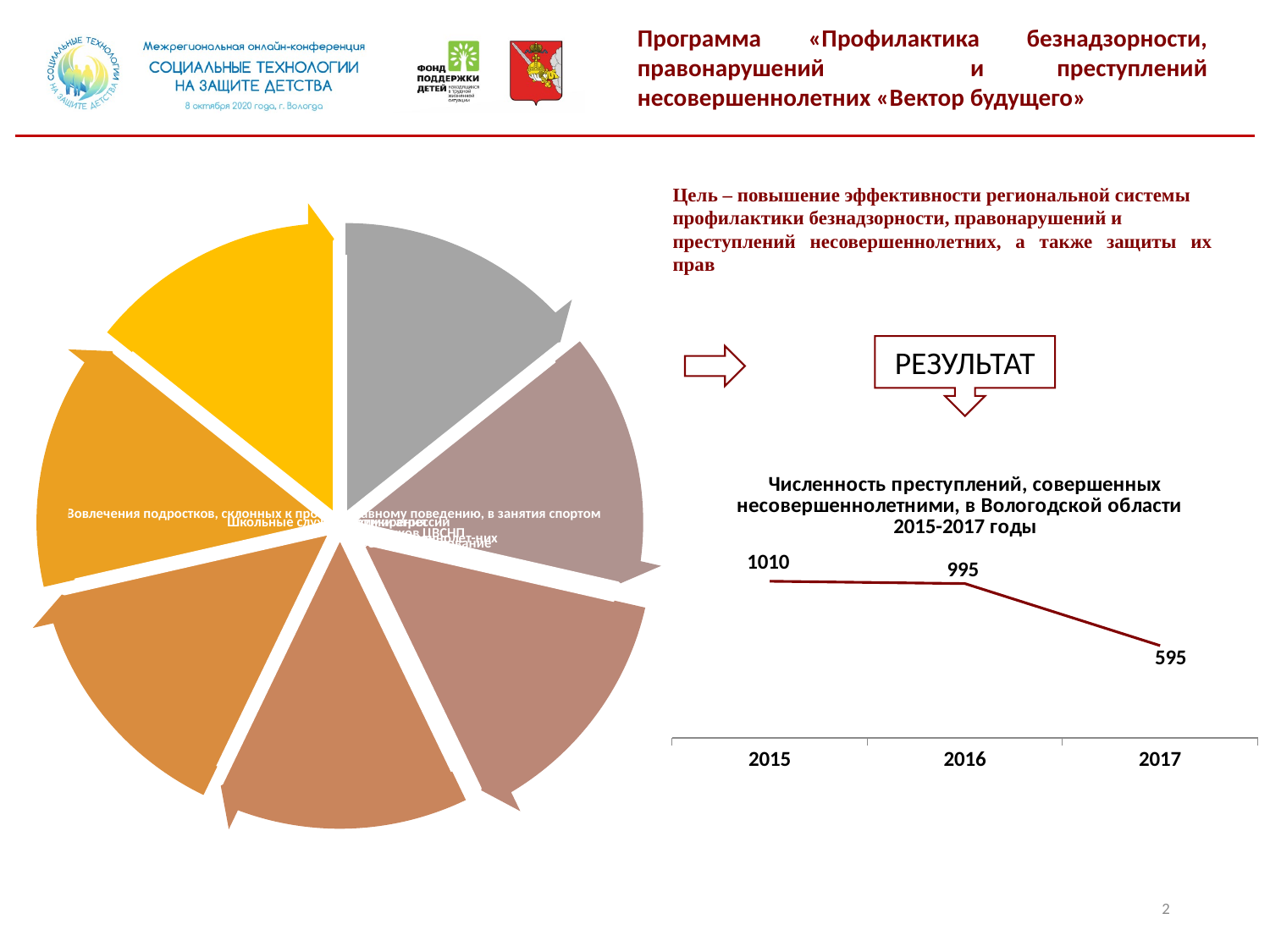
In the line chart on the right of the slide, what is the difference between the values for 2015 and 2016? 15 In the line chart on the right of the slide, which is larger: the value for 2015 or the value for 2017? 2015 What kind of chart is shown on the right of the slide under the word "РЕЗУЛЬТАТ"? line chart In the line chart on the right of the slide, which year has the highest value? 2015 What is the title of the line chart on the right of the slide? Численность преступлений, совершенных несовершеннолетними, в Вологодской области 2015-2017 годы In the chart titled "Численность преступлений, совершенных несовершеннолетними, в Вологодской области 2015-2017 годы", what is the value for 2015? 1010 In the line chart on the right of the slide, what is the value for 2017? 595 In the line chart on the right of the slide, which year has the lowest value? 2017 In the line chart on the right of the slide, do the values rise or fall from 2015 to 2017? fall In the line chart on the right of the slide, what is the difference between the values for 2016 and 2017? 400 How many years are plotted in the line chart on the right of the slide? 3 In the line chart on the right of the slide, what is the value for 2016? 995